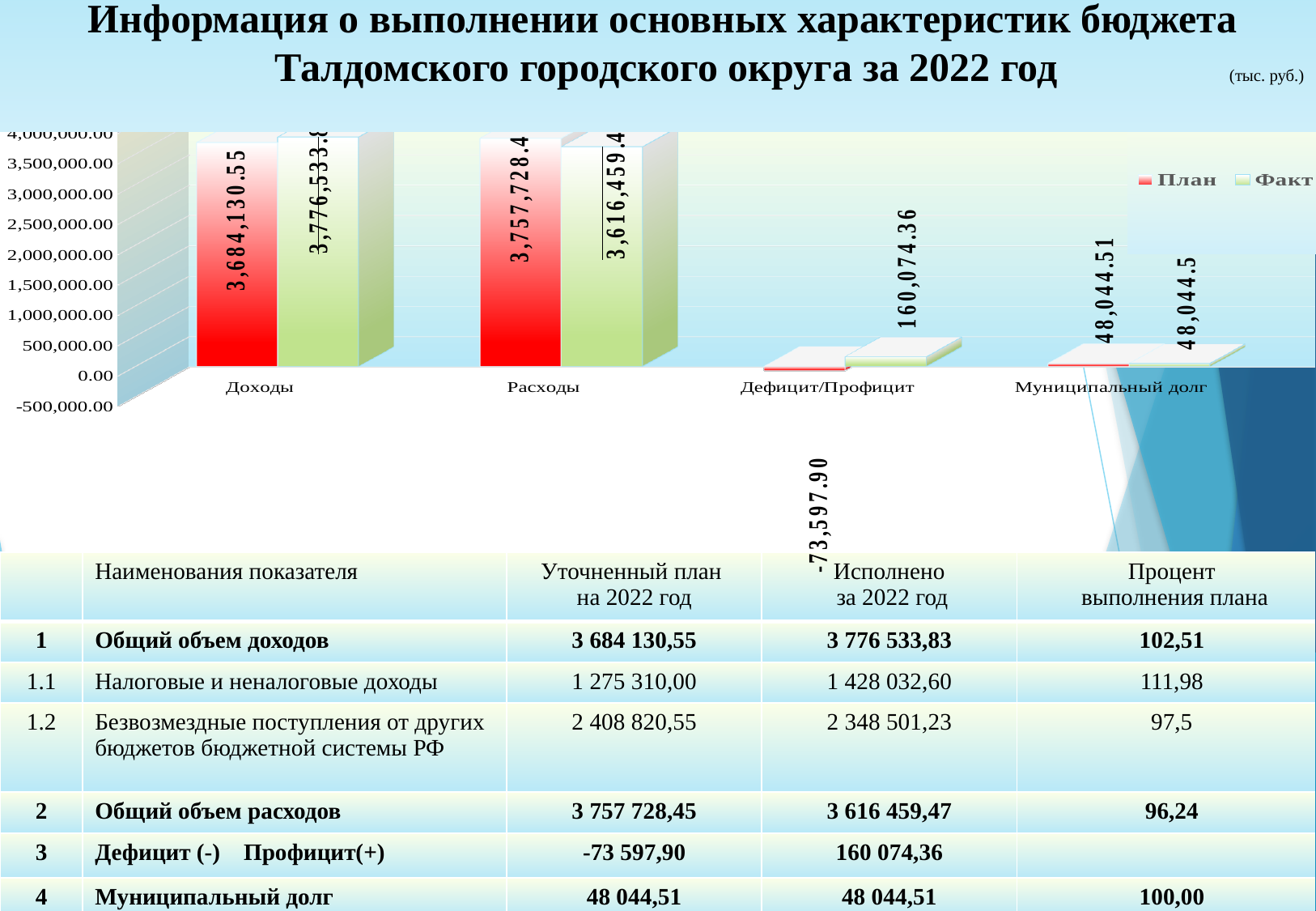
Which is larger: the Факт value for Доходы or the Факт value for Расходы? Доходы Which category has the lowest value in the chart? Дефицит/Профицит (План) What is the План value for Дефицит/Профицит? -73,597.90 What is the План value for Муниципальный долг? 48,044.51 What is the Факт value for Дефицит/Профицит? 160,074.36 What kind of chart is shown on the slide? bar chart Is the Факт value for Доходы greater or less than 3,500,000.00? greater What is the difference between the Факт and План values for Дефицит/Профицит? 233,672.26 How many categories are shown on the x axis of the chart? 4 Which is larger: the План value for Доходы or the План value for Расходы? Расходы What is the План value for Доходы? 3,684,130.55 How many series does the legend list? 2